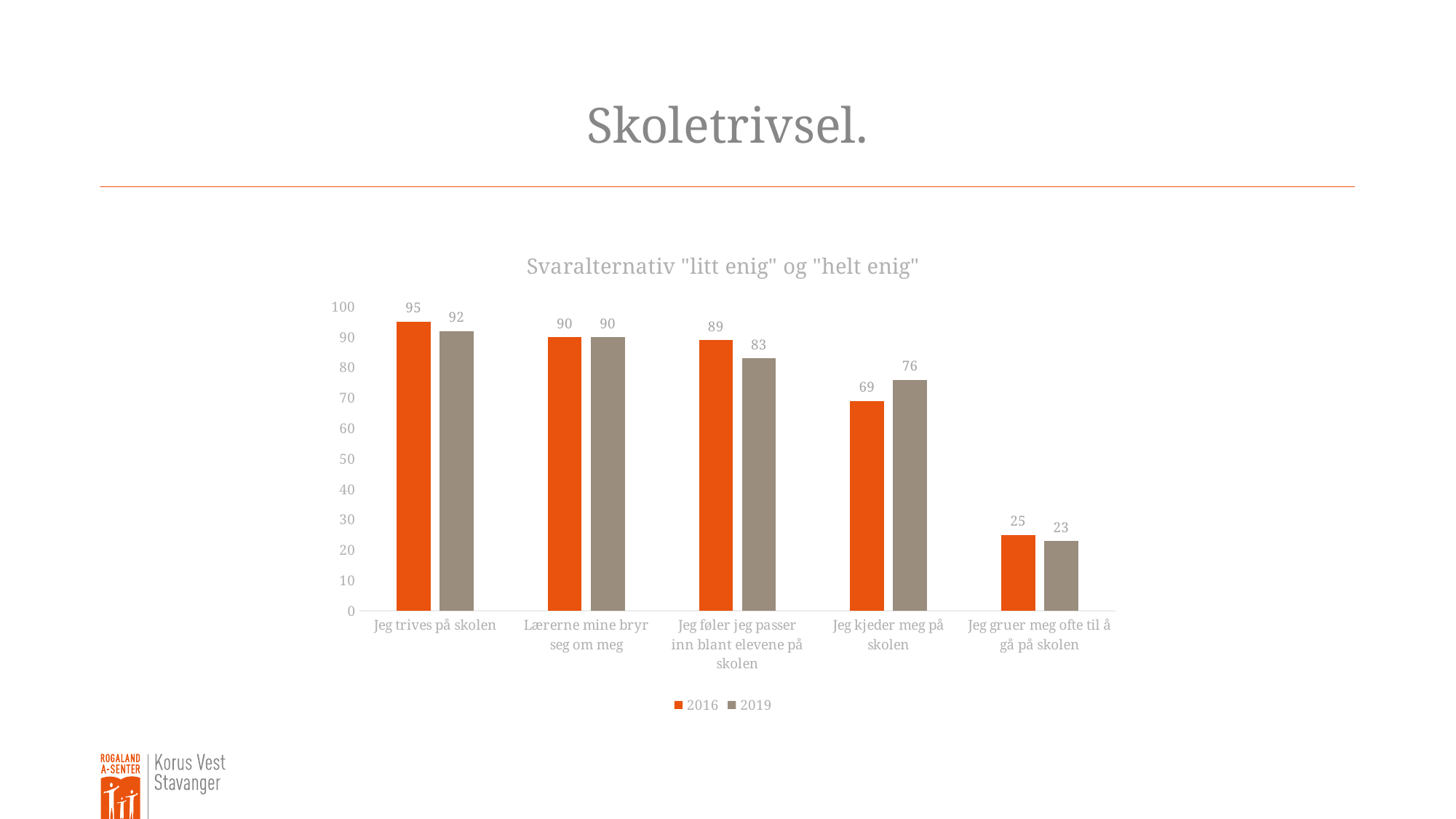
What is the difference between the 2016 and 2019 values for "Jeg føler jeg passer inn blant elevene på skolen"? 6 Which category has the highest 2019 value? Jeg trives på skolen What is the difference between the 2016 and 2019 values for "Jeg kjeder meg på skolen"? 7 What is the 2016 value for "Jeg trives på skolen"? 95 How many series does the legend list? 2 How many categories are shown on the x axis? 5 Which category has the lowest 2016 value? Jeg gruer meg ofte til å gå på skolen What is the 2019 value for "Jeg kjeder meg på skolen"? 76 For "Jeg gruer meg ofte til å gå på skolen", which year has the larger value, 2016 or 2019? 2016 What is the title of the chart? Svaralternativ "litt enig" og "helt enig" What kind of chart is shown on the slide? Bar chart What is the 2019 value for "Jeg føler jeg passer inn blant elevene på skolen"? 83